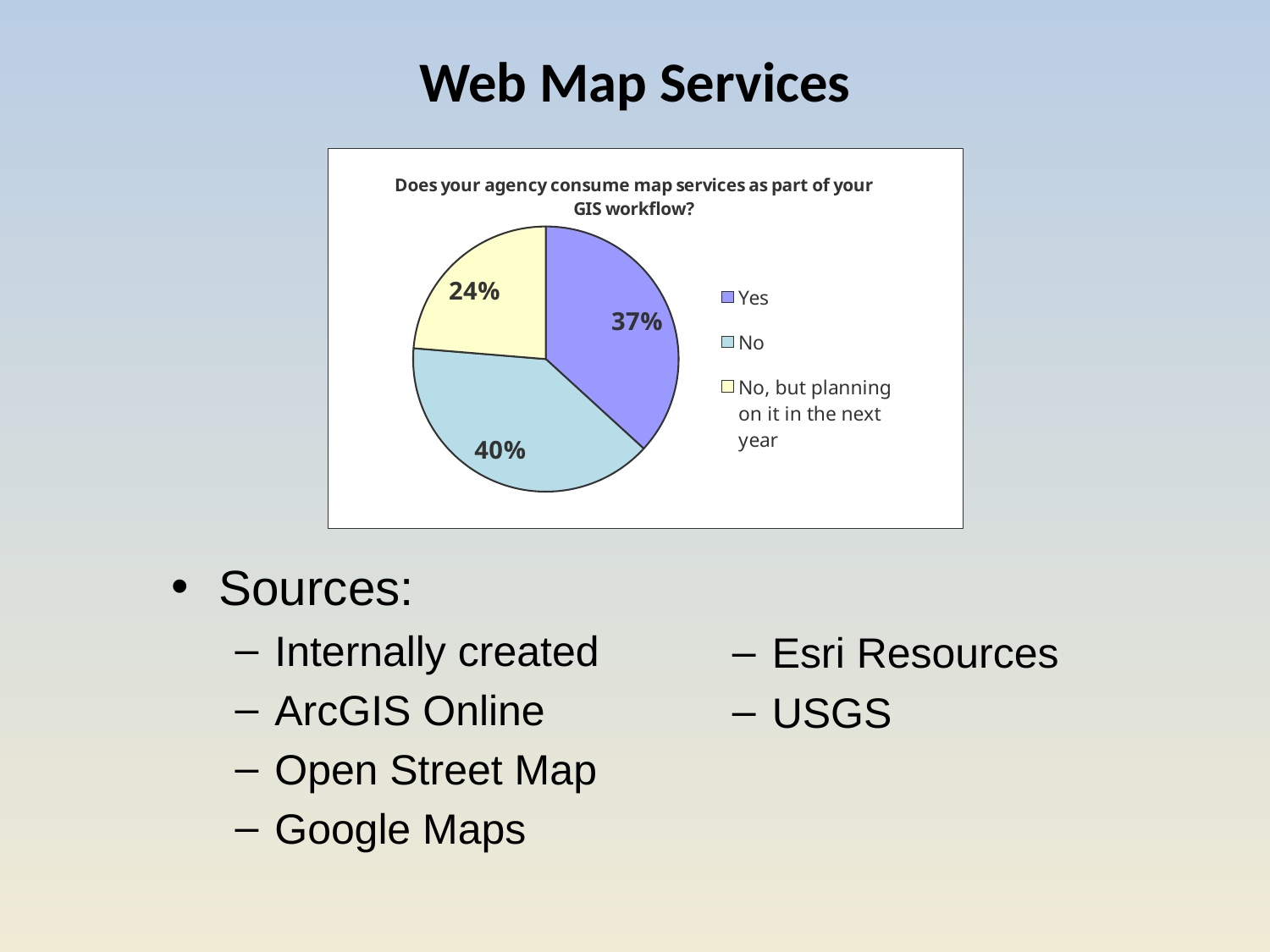
What is the difference in percentage points between the "No" and "Yes" slices? 3 What percentage of respondents answered "No"? 40% Which is larger, the "Yes" slice or the "No, but planning on it in the next year" slice? Yes What kind of chart is shown on the slide? pie chart What percentage of respondents answered "Yes"? 37% Which response has the largest share of the pie? No How many slices does the pie chart have? 3 What percentage of respondents answered "No, but planning on it in the next year"? 24% What colour is the "Yes" slice in the pie chart? purple What is the difference in percentage points between the "Yes" slice and the "No, but planning on it in the next year" slice? 13 What is the title of the pie chart? Does your agency consume map services as part of your GIS workflow? Which response has the smallest share of the pie? No, but planning on it in the next year